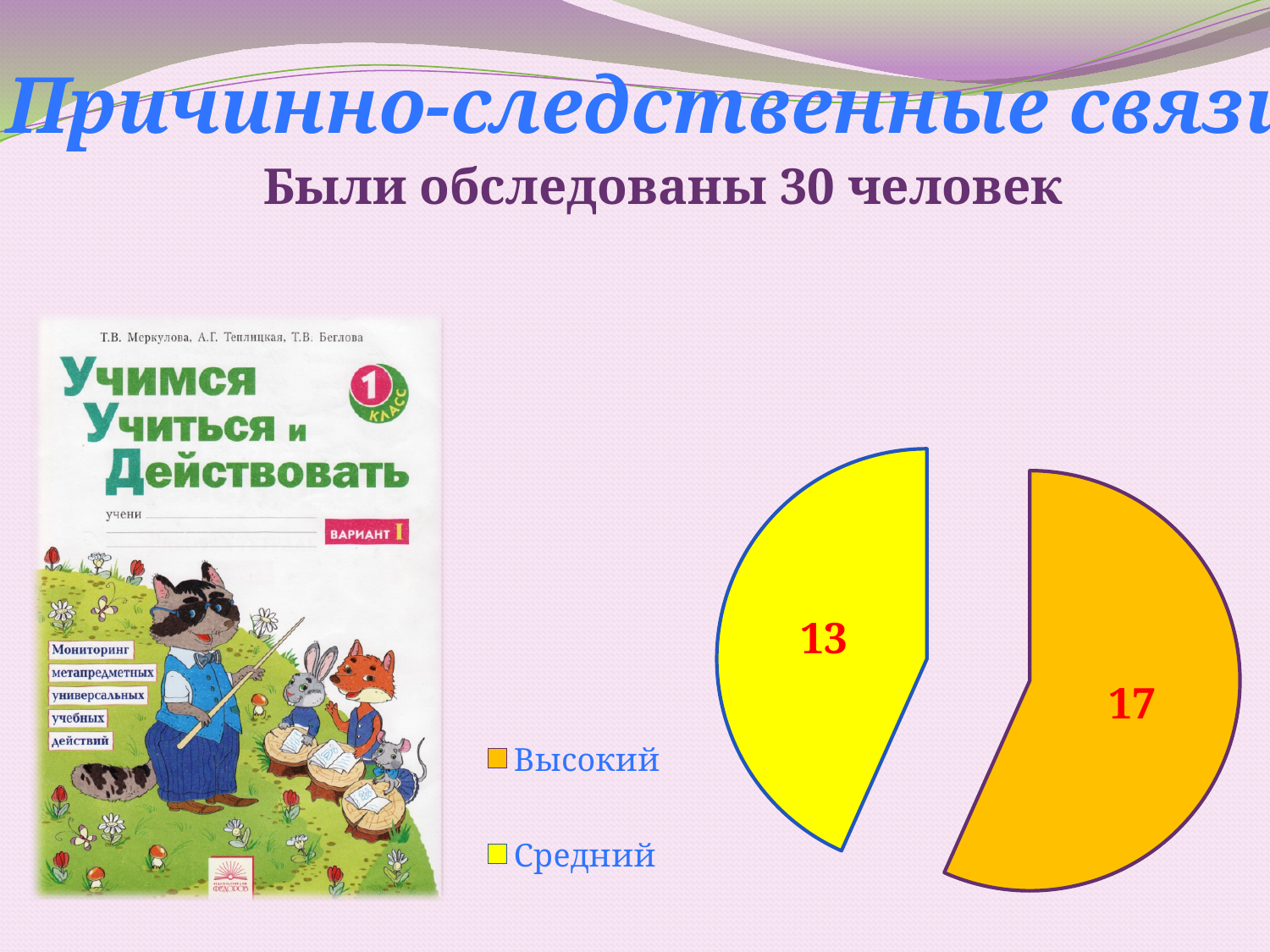
What is the total of all slices in the pie chart? 30 How many entries does the legend list? 2 What is the difference between the values for Высокий and Средний? 4 Which is larger, the value for Высокий or the value for Средний? Высокий Which category has the largest slice in the pie chart? Высокий What is the value for Средний in the pie chart? 13 What kind of chart is shown on the slide? pie chart What colour is the Средний slice in the pie chart? yellow What is the value for Высокий in the pie chart? 17 What colour is the Высокий slice in the pie chart? orange Which category has the smallest slice in the pie chart? Средний How many slices does the pie chart have? 2